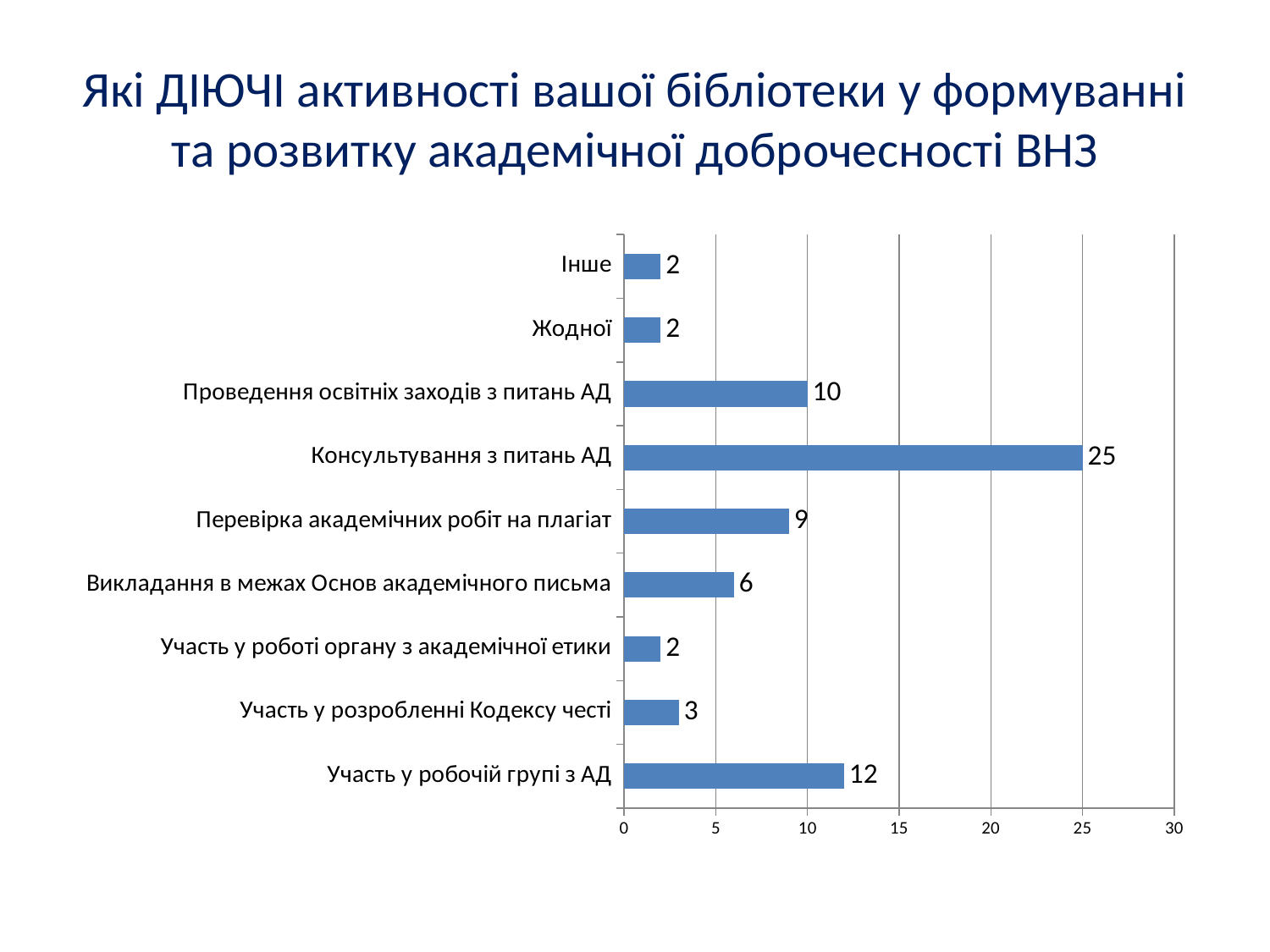
What is the value for "Консультування з питань АД"? 25 What is the maximum value shown on the horizontal axis? 30 What is the value for "Участь у робочій групі з АД"? 12 Which is larger: the value for "Участь у робочій групі з АД" or the value for "Проведення освітніх заходів з питань АД"? Участь у робочій групі з АД What is the value for "Участь у розробленні Кодексу честі"? 3 How many categories are shown in the chart? 9 What is the value for "Перевірка академічних робіт на плагіат"? 9 Which category has the highest value? Консультування з питань АД What kind of chart is shown on the slide? bar chart What is the difference between the values for "Консультування з питань АД" and "Проведення освітніх заходів з питань АД"? 15 Is the value for "Консультування з питань АД" greater or less than 20? greater What is the value for "Викладання в межах Основ академічного письма"? 6